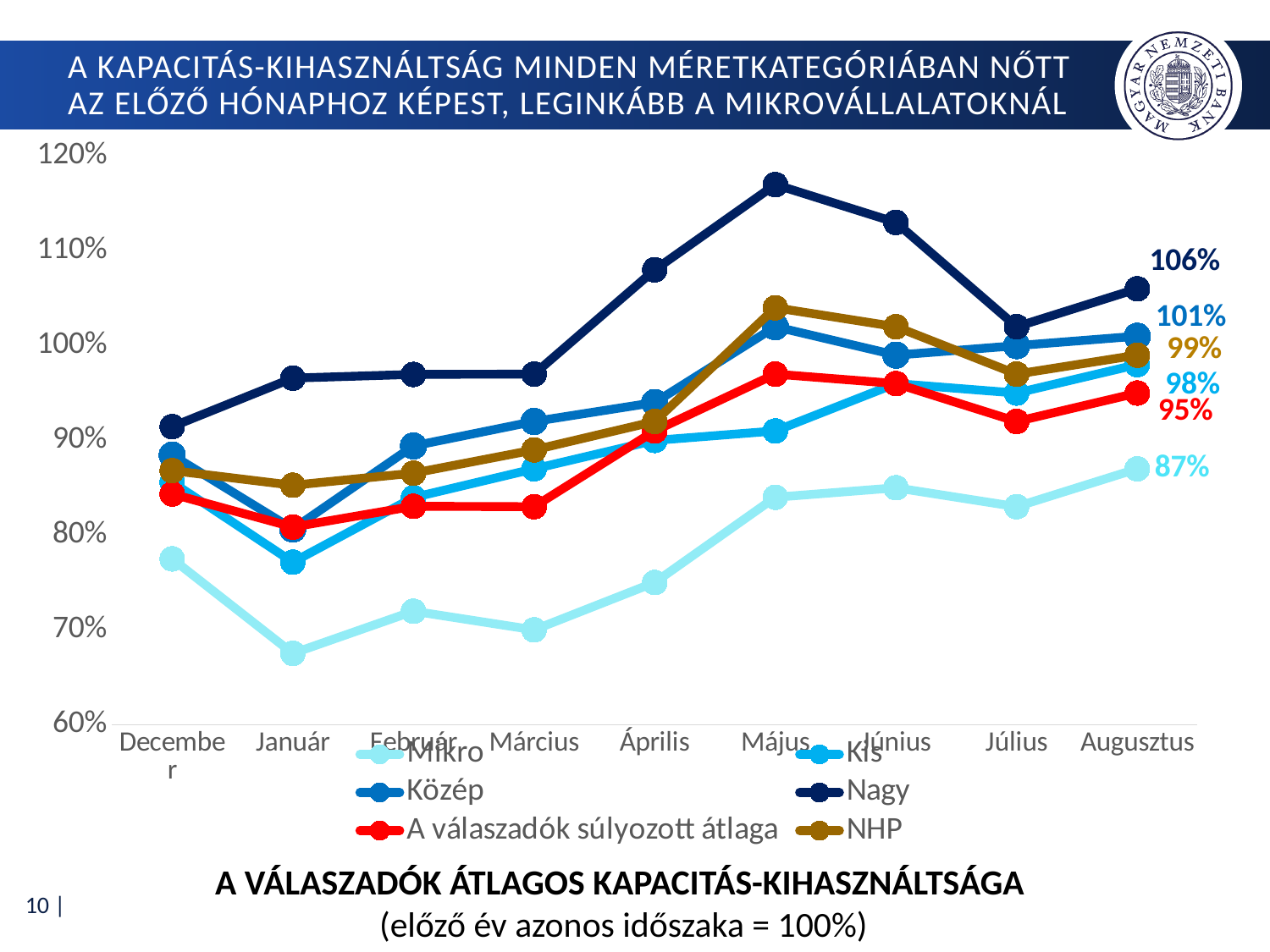
How many series does the legend list? 6 Which series has the highest value in Augusztus? Nagy What is the value for Mikro in Augusztus? 87% What is the value for NHP in Augusztus? 99% What is the value for A válaszadók súlyozott átlaga in Augusztus? 95% Which series has the lowest value in Augusztus? Mikro What is the difference between the Augusztus values of Nagy and Mikro? 19 percentage points Is the value for Mikro in Január greater or less than 70%? less Is the value for Nagy in Május greater or less than 110%? greater How many months are shown on the x axis? 9 What type of chart is shown on the slide? line chart What is the value for Nagy in Augusztus? 106%